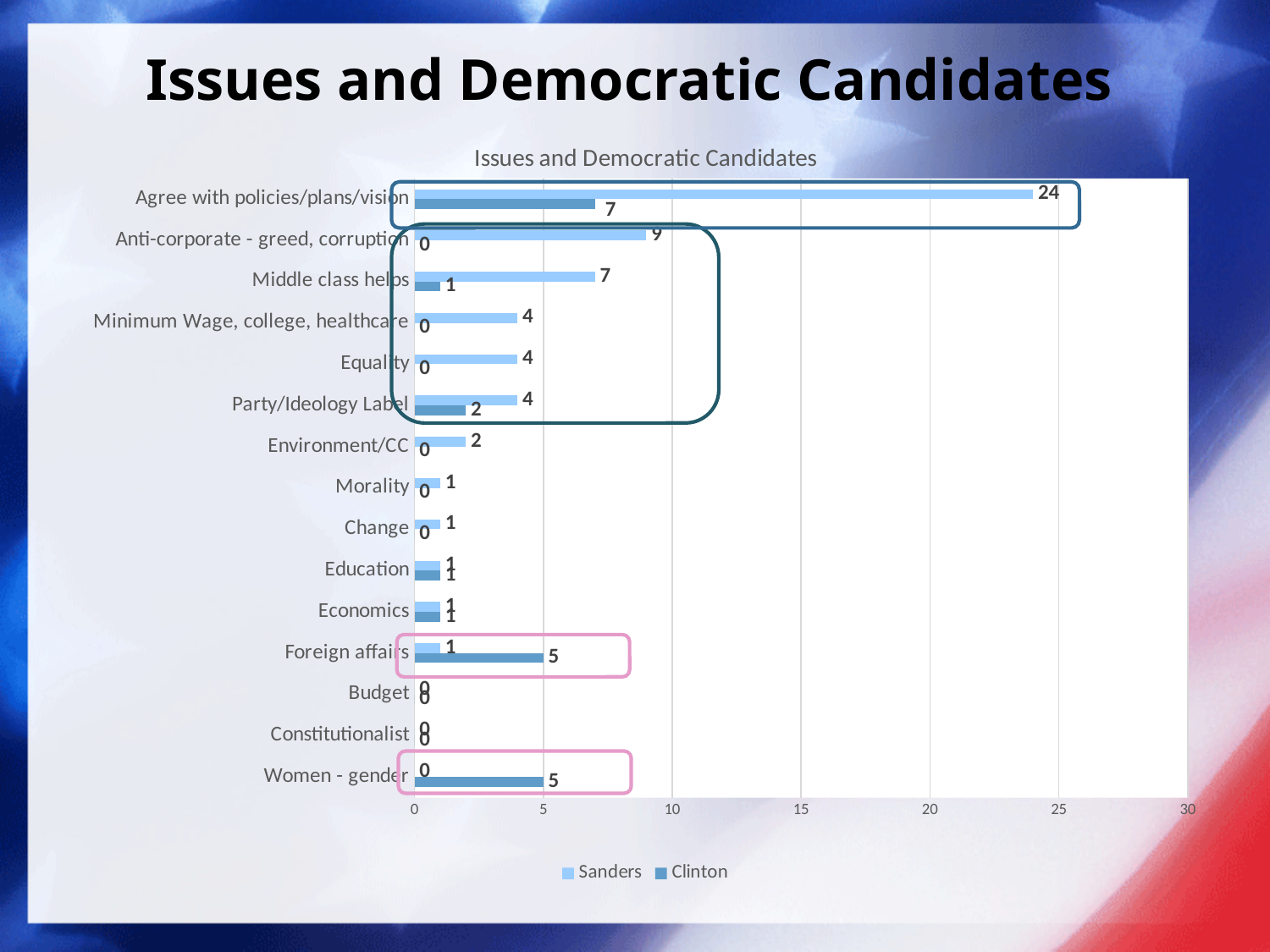
What is the difference between the Sanders and Clinton values for Agree with policies/plans/vision? 17 How many categories are shown on the chart? 15 What kind of chart is shown on the slide? Bar chart What is the Clinton value for Foreign affairs? 5 Which category has the highest Sanders value? Agree with policies/plans/vision What is the Clinton value for Women - gender? 5 What is the Sanders value for Agree with policies/plans/vision? 24 How many series does the legend list? 2 Which category has the highest Clinton value? Agree with policies/plans/vision What are the two series named in the legend? Sanders and Clinton For Foreign affairs, which is larger: the Sanders value or the Clinton value? Clinton What is the Sanders value for Anti-corporate - greed, corruption? 9